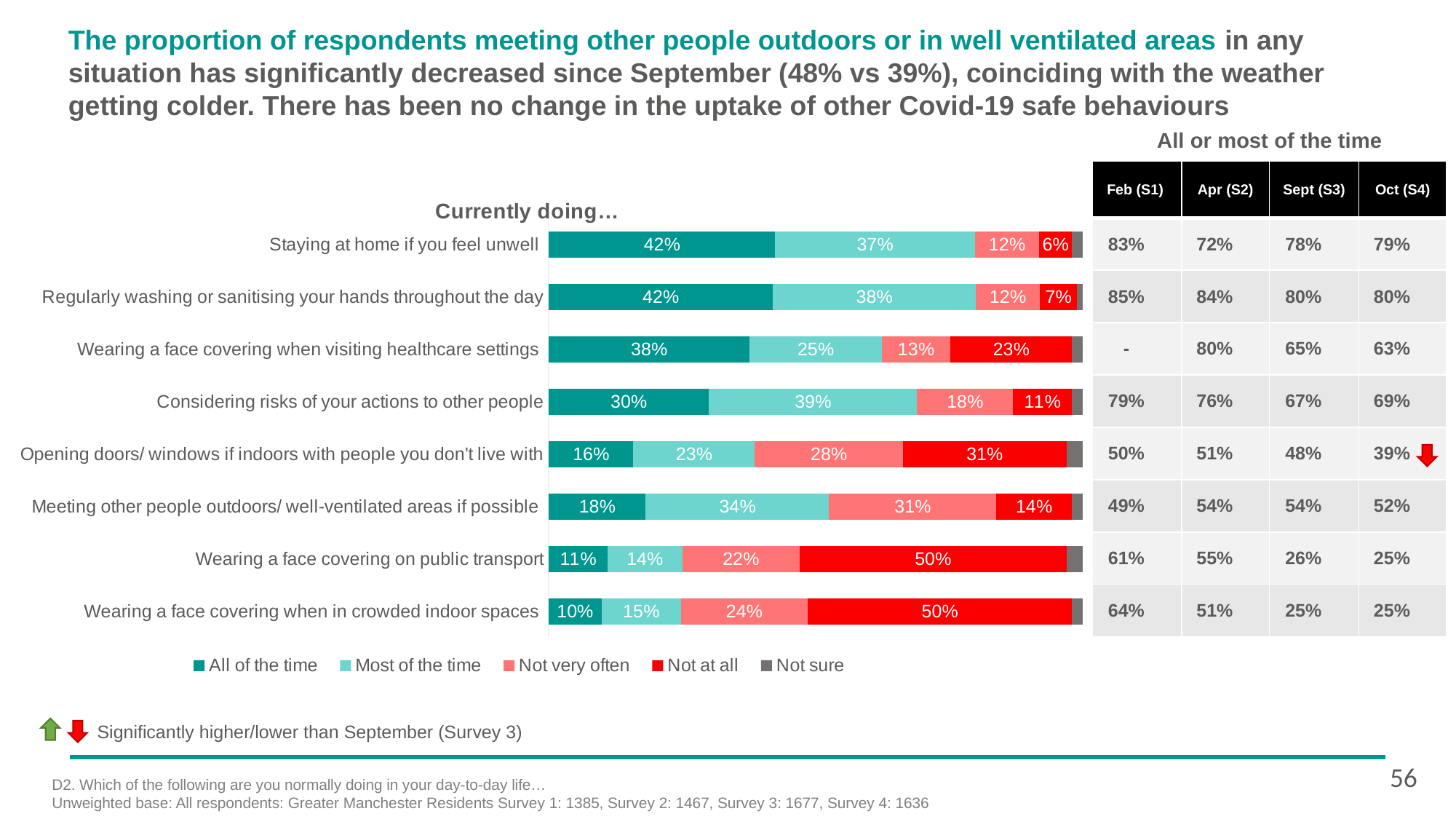
How many series does the chart legend list? 5 Which behaviour has the highest 'Most of the time' value? Considering risks of your actions to other people What colour represents the 'Not at all' series in the chart? Red Which is larger: the 'Not very often' value for 'Opening doors/ windows if indoors with people you don't live with' or for 'Wearing a face covering when in crowded indoor spaces'? Opening doors/ windows if indoors with people you don't live with What is the 'All of the time' value for 'Wearing a face covering when visiting healthcare settings'? 38% What type of chart is shown on the slide? Stacked bar chart What is the 'Not at all' value for 'Opening doors/ windows if indoors with people you don't live with'? 31% Which behaviour has the lowest 'Not at all' value? Staying at home if you feel unwell How many behaviours (categories) are plotted in the chart? 8 What is the difference between the 'Not at all' values for 'Wearing a face covering on public transport' and 'Considering risks of your actions to other people'? 39% Which behaviour has the lowest 'All of the time' value? Wearing a face covering when in crowded indoor spaces What is the 'Most of the time' value for 'Meeting other people outdoors/ well-ventilated areas if possible'? 34%